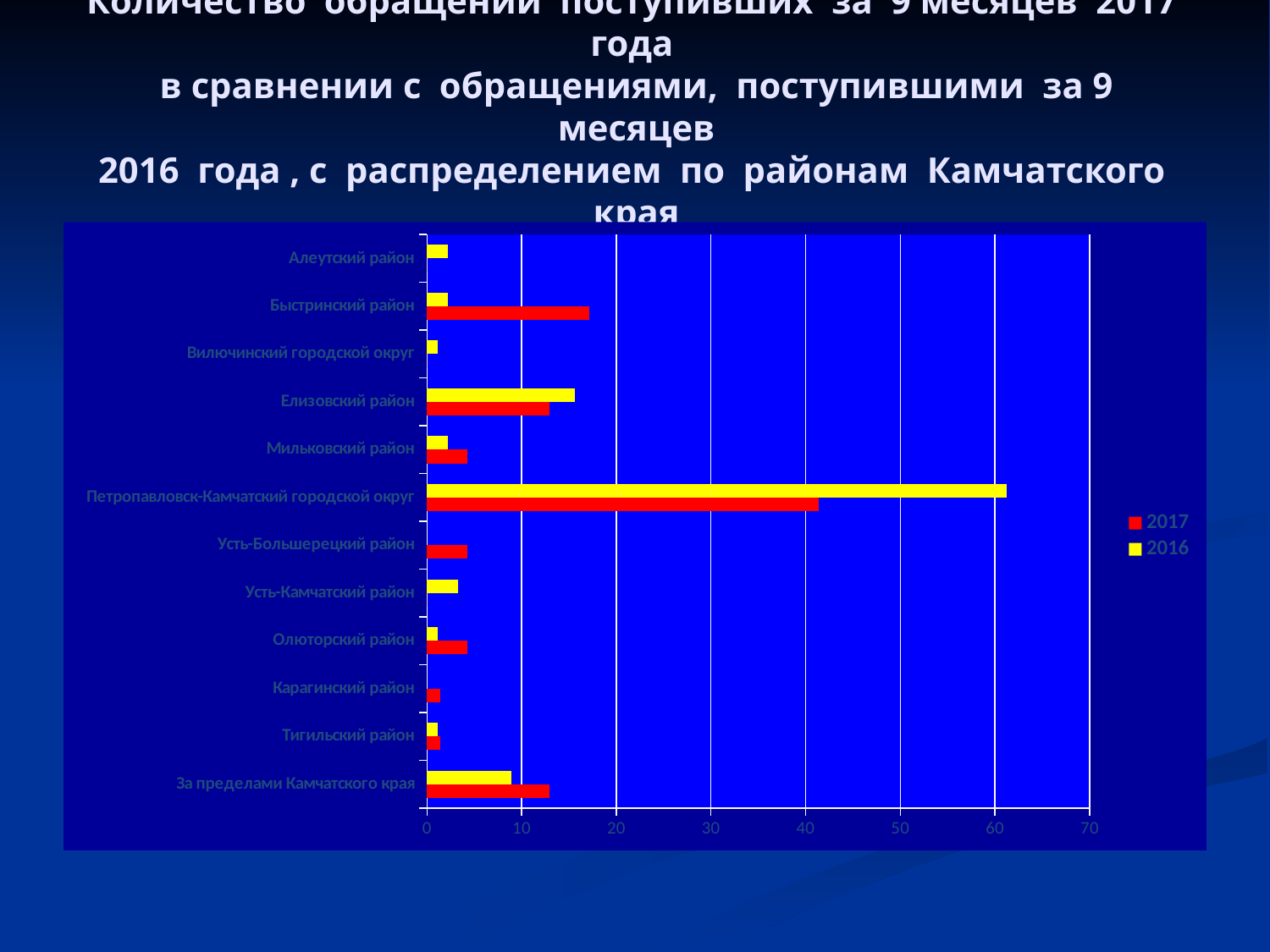
For За пределами Камчатского края, which series has the larger value, 2017 or 2016? 2017 Is the 2017 value for Петропавловск-Камчатский городской округ greater or less than 50? less How many categories (districts) are shown on the vertical axis of the chart? 12 Is the 2017 value for Быстринский район greater or less than 10? greater Which colour represents the 2017 series in the legend? red How many series does the legend list? 2 Which category has the highest value for the 2016 series? Петропавловск-Камчатский городской округ For Петропавловск-Камчатский городской округ, which series has the larger value, 2017 or 2016? 2016 Is the 2016 value for Петропавловск-Камчатский городской округ greater or less than 60? greater Which category has the highest value for the 2017 series? Петропавловск-Камчатский городской округ Which colour represents the 2016 series in the legend? yellow What kind of chart is shown on the slide? bar chart